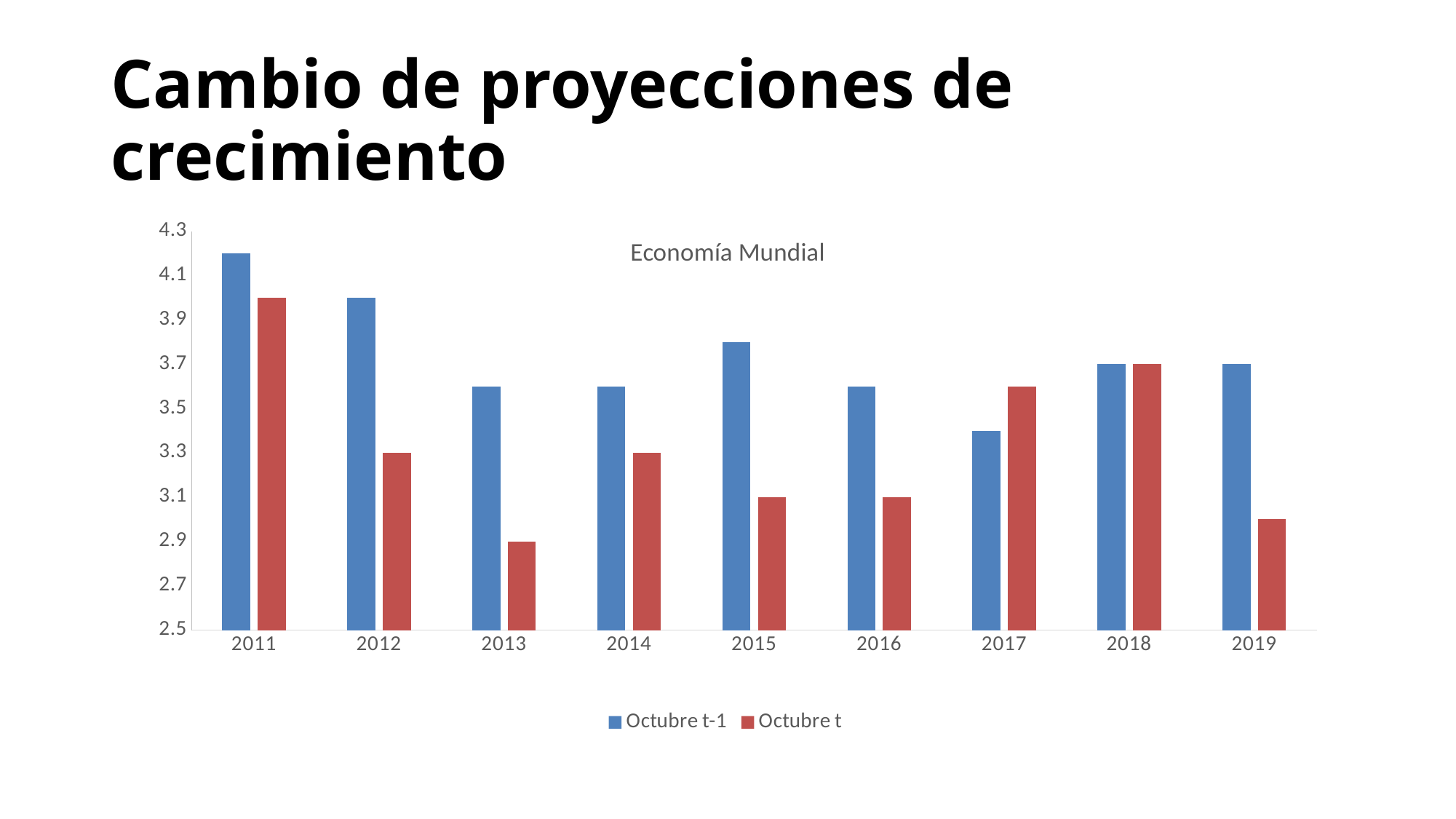
In which year is the Octubre t-1 value highest? 2011 In which year is the Octubre t value lowest? 2013 In 2017, which series has the larger value, Octubre t-1 or Octubre t? Octubre t Which series is shown in red in the legend? Octubre t How many series does the legend list? 2 How many years are shown on the x axis? 9 Is the Octubre t value for 2013 greater or less than 3.1? less What is the title shown inside the chart area? Economía Mundial In which year is the Octubre t-1 value lowest? 2017 What kind of chart is shown on the slide? Bar chart Is the Octubre t-1 value for 2011 greater or less than 4.1? greater Is the Octubre t-1 value for 2017 greater or less than 3.5? less